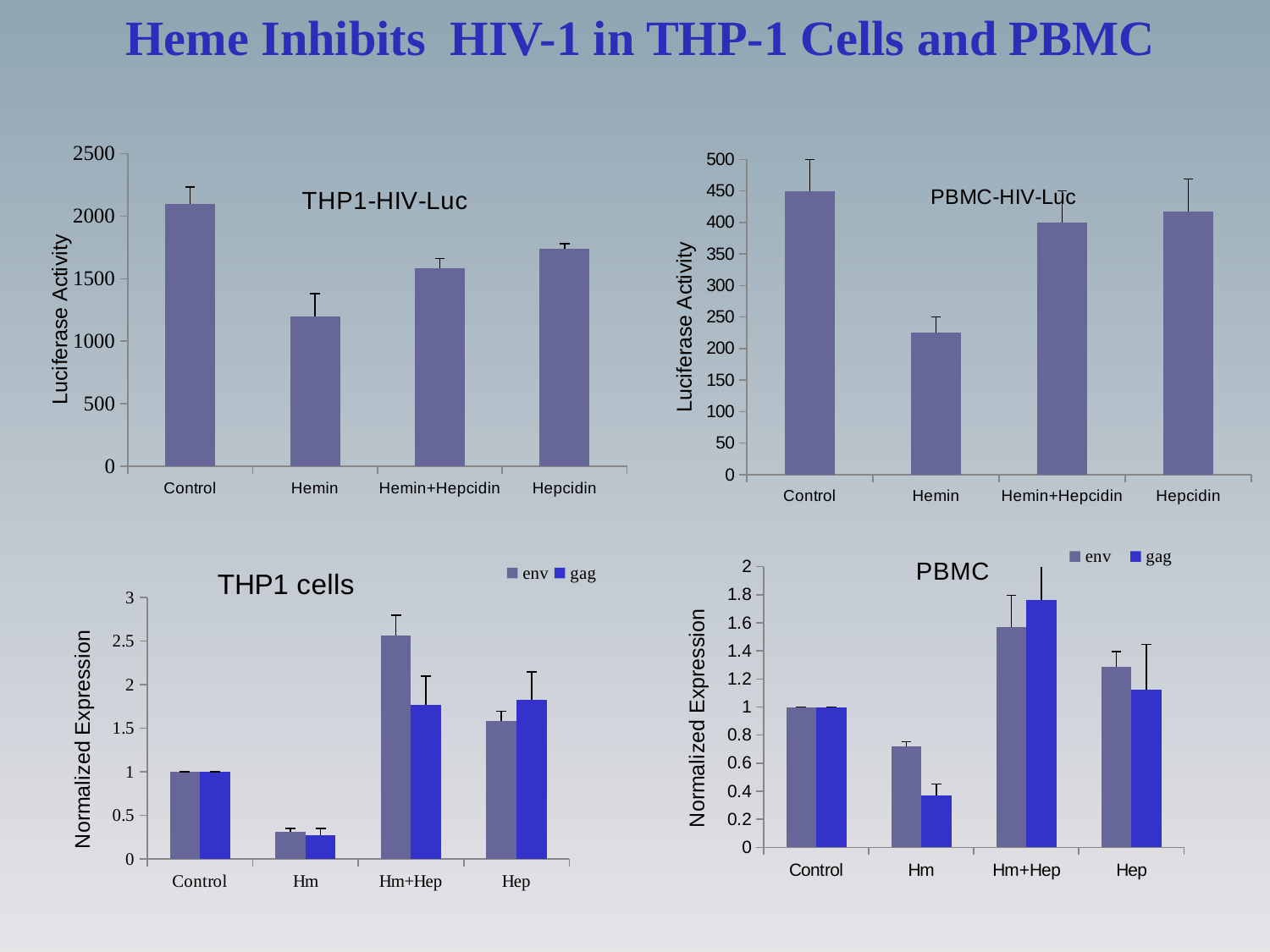
In the PBMC-HIV-Luc chart, which category has the lowest luciferase activity? Hemin In the THP1 cells chart, what is the normalized expression of env for Control? 1 In the THP1-HIV-Luc chart, which category has the highest luciferase activity? Control In the THP1-HIV-Luc chart, which category has the lowest luciferase activity? Hemin In the THP1 cells chart, which category has the highest env value? Hm+Hep In the PBMC-HIV-Luc chart, is the value for Hemin greater or less than 250? less In the THP1 cells chart, for Hm+Hep, which is larger, env or gag? env How many series does the legend of the PBMC chart (bottom right) list? 2 How many categories are shown on the x axis of the PBMC-HIV-Luc chart? 4 What kind of chart is the PBMC chart at the bottom right? bar chart In the THP1-HIV-Luc chart, is the value for Control greater or less than 2000? greater In the PBMC chart (bottom right), for Hm, which is larger, env or gag? env